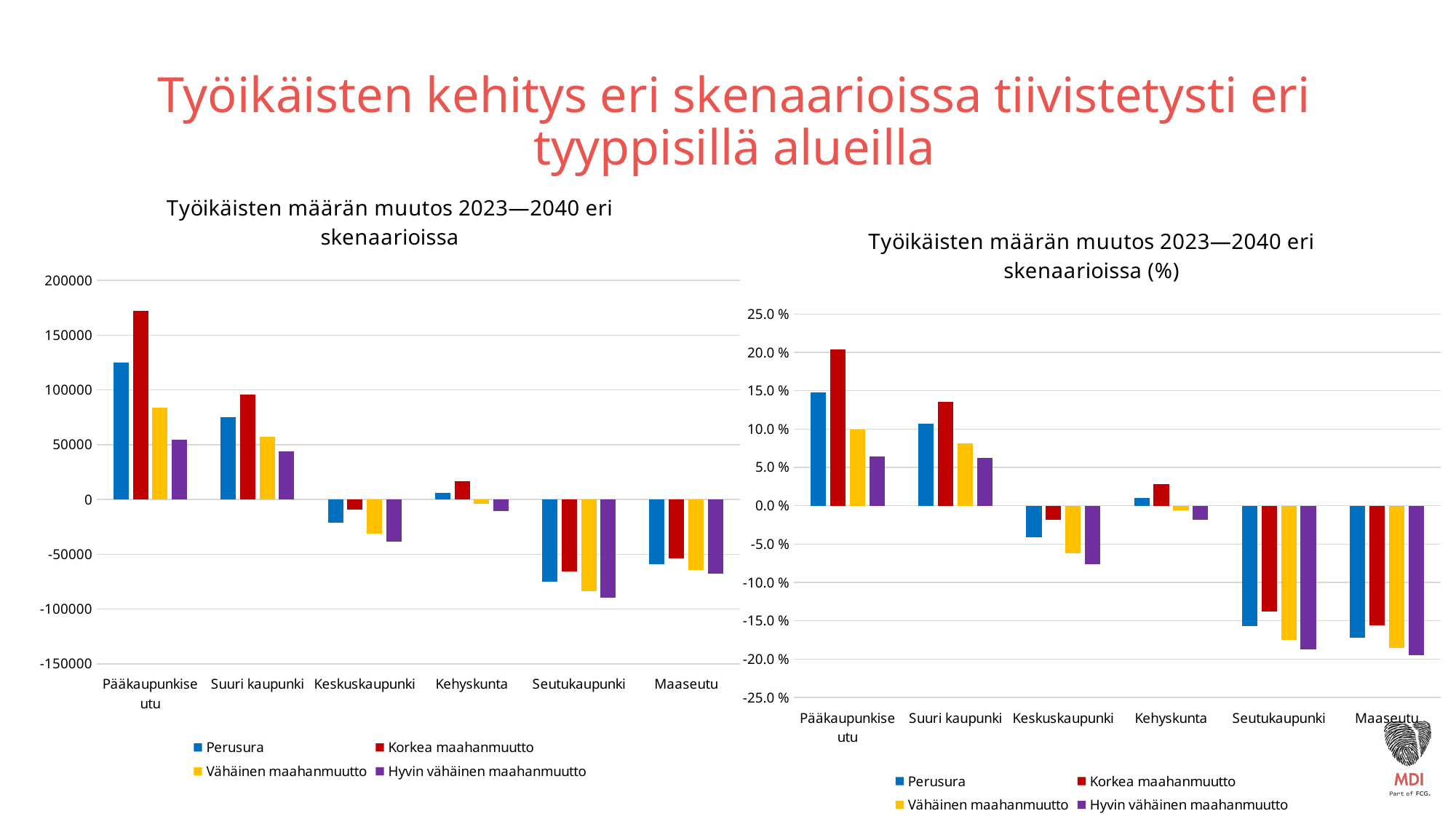
In the left chart, which is larger: the Perusura value for Pääkaupunkiseutu or the Korkea maahanmuutto value for Suuri kaupunki? Perusura value for Pääkaupunkiseutu In the right chart, which is larger: the Vähäinen maahanmuutto value for Pääkaupunkiseutu or the Vähäinen maahanmuutto value for Suuri kaupunki? Pääkaupunkiseutu In the left chart, which category and series has the lowest bar? Hyvin vähäinen maahanmuutto for Seutukaupunki In the left chart, which category and series has the highest bar? Korkea maahanmuutto for Pääkaupunkiseutu In the right chart, is the Hyvin vähäinen maahanmuutto value for Maaseutu greater or less than -15.0 %? less How many series does the legend of the right chart, 'Työikäisten määrän muutos 2023—2040 eri skenaarioissa (%)', list? 4 In the right chart, is the Korkea maahanmuutto value for Pääkaupunkiseutu greater or less than 15.0 %? greater In the left chart, is the Hyvin vähäinen maahanmuutto value for Seutukaupunki greater or less than -50000? less What kind of chart is the left chart, 'Työikäisten määrän muutos 2023—2040 eri skenaarioissa'? Bar chart How many categories are shown on the x axis of the left chart? 6